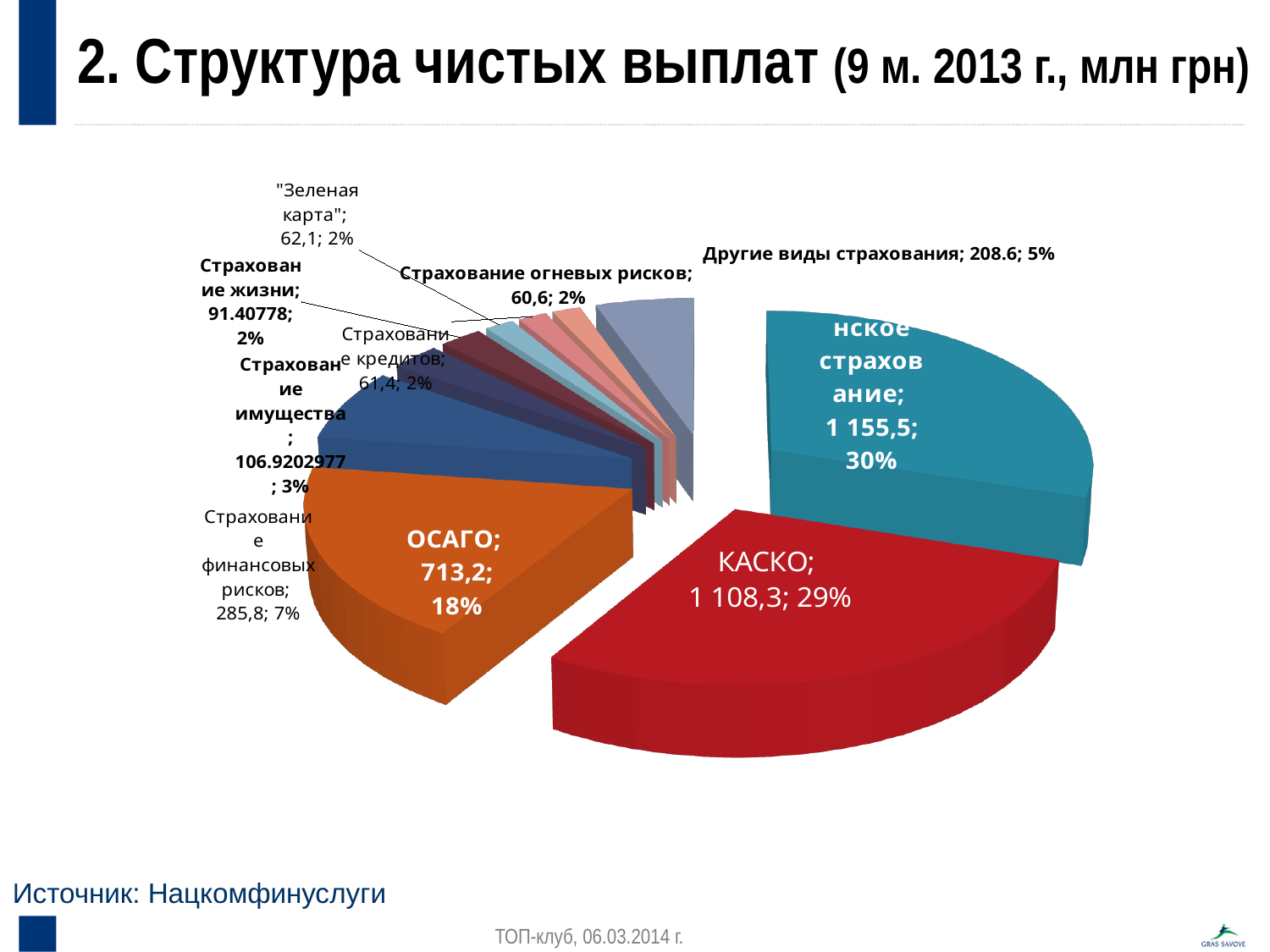
How many slices does the pie chart have? 10 What is the value shown for КАСКО? 1 108,3 Which is larger, the value for ОСАГО or the value for КАСКО? КАСКО What share of the pie does КАСКО represent? 29% What is the value shown for Другие виды страхования? 208.6 What is the value shown for Страхование финансовых рисков? 285,8 What is the value shown for Страхование огневых рисков? 60,6 What is the difference between the values for КАСКО and ОСАГО? 395,1 What kind of chart is shown on the slide? pie chart What share of the pie does "Зеленая карта" represent? 2% What is the value shown for ОСАГО? 713,2 What share of the pie does ОСАГО represent? 18%